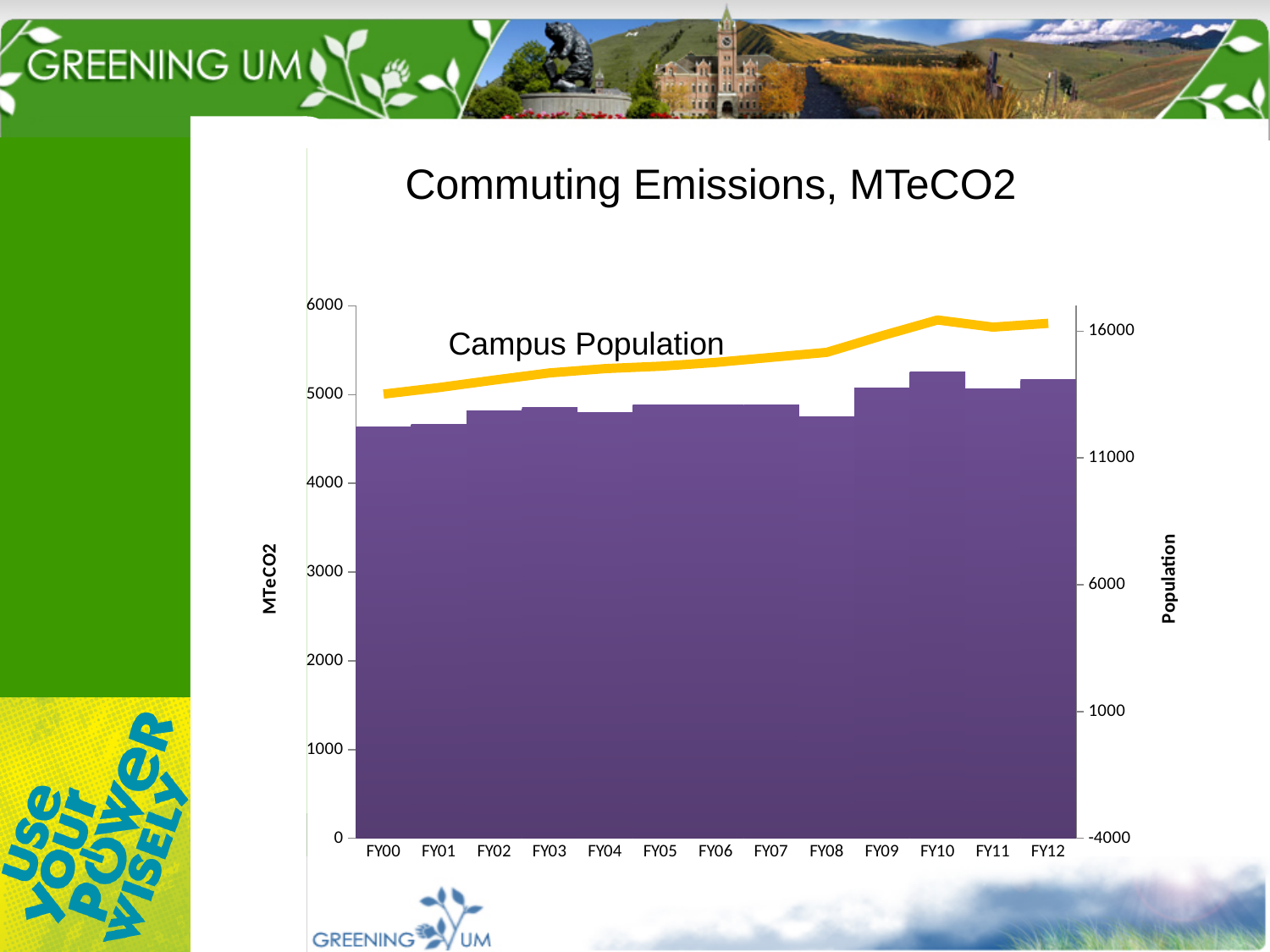
Is the commuting emissions value for FY10 greater or less than 5000? greater Does the Campus Population line generally rise or fall from FY00 to FY12? rise What is the title of the chart? Commuting Emissions, MTeCO2 Is the commuting emissions value for FY00 greater or less than 5000? less How many fiscal years are shown on the x axis of the Commuting Emissions chart? 13 Is the commuting emissions value for FY08 greater or less than 5000? less What kind of chart is used to show the commuting emissions by fiscal year? bar chart Which has higher commuting emissions, FY08 or FY09? FY09 What is the label of the right-hand vertical axis? Population Which fiscal year has the highest commuting emissions bar? FY10